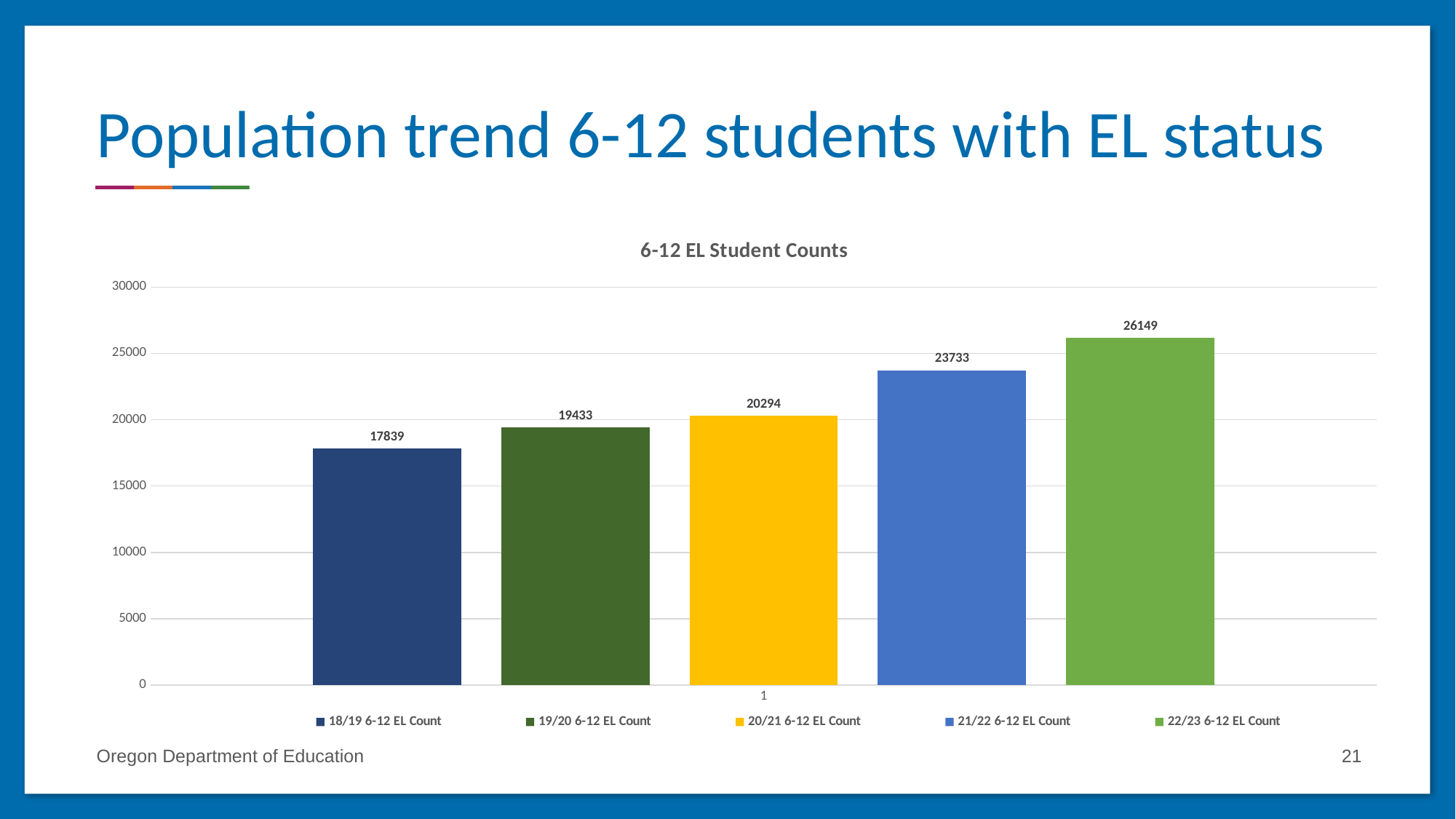
Is the value for 22/23 6-12 EL Count greater or less than 25000? greater How many series does the legend list? 5 What is the difference between the 21/22 6-12 EL Count and the 20/21 6-12 EL Count? 3439 Which series has the lowest value? 18/19 6-12 EL Count Do the EL student counts rise or fall from 18/19 to 22/23? rise Which is larger, the 19/20 6-12 EL Count or the 21/22 6-12 EL Count? 21/22 6-12 EL Count What is the value for 18/19 6-12 EL Count? 17839 What is the value for 21/22 6-12 EL Count? 23733 What kind of chart is shown on the slide? bar chart What is the value for 20/21 6-12 EL Count? 20294 What is the difference between the 22/23 6-12 EL Count and the 18/19 6-12 EL Count? 8310 Which series has the highest value? 22/23 6-12 EL Count